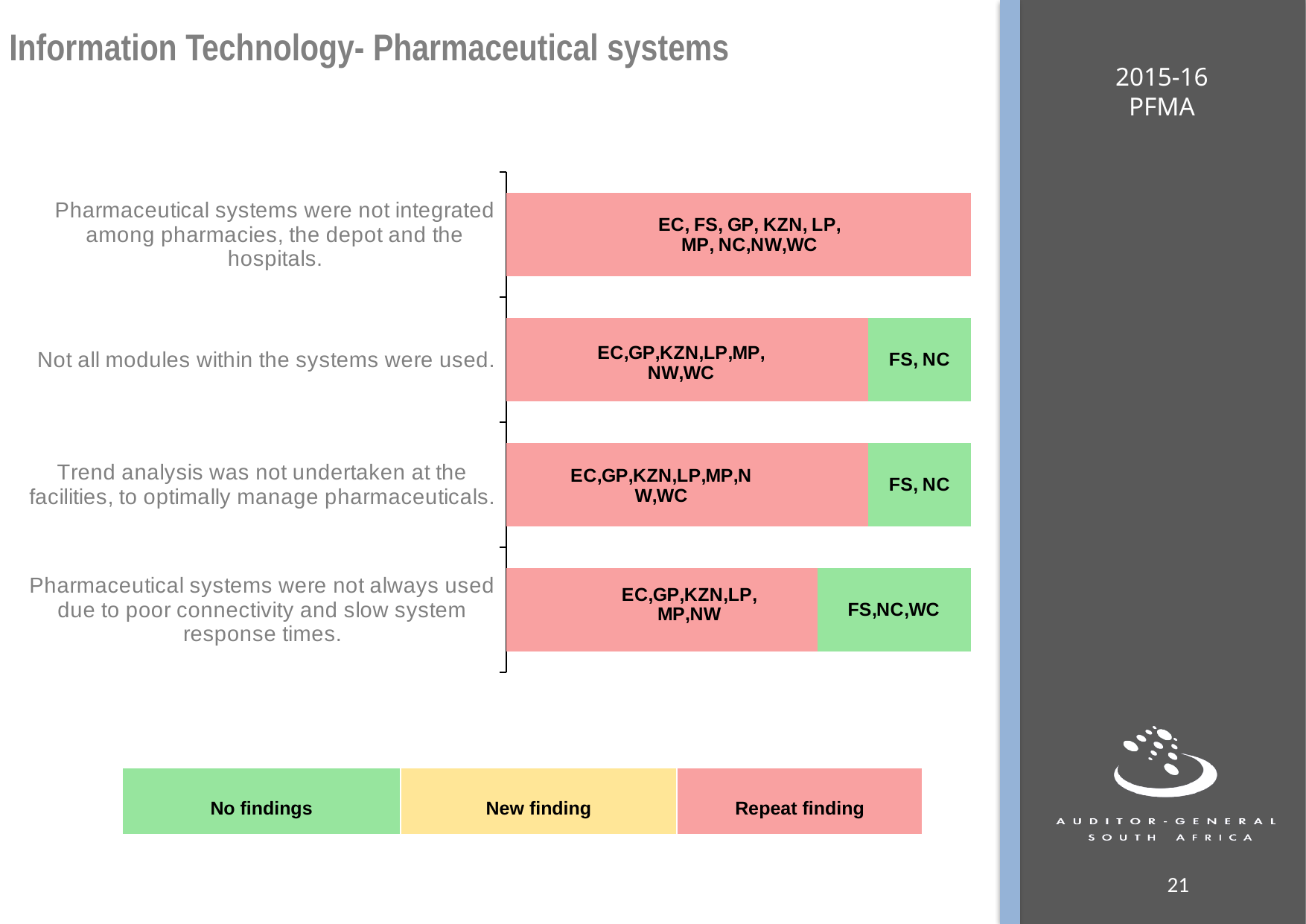
Which finding has no 'No findings' segment at all? Pharmaceutical systems were not integrated among pharmacies, the depot and the hospitals. Which provinces are listed in the 'No findings' segment for 'Not all modules within the systems were used'? FS, NC How many entries does the legend at the bottom of the slide list? 3 Which provinces are listed in the 'Repeat finding' segment for 'Trend analysis was not undertaken at the facilities, to optimally manage pharmaceuticals'? EC, GP, KZN, LP, MP, NW, WC How many provinces are listed in the 'Repeat finding' segment for 'Pharmaceutical systems were not always used due to poor connectivity and slow system response times'? 6 Which provinces are listed in the 'Repeat finding' segment for 'Pharmaceutical systems were not integrated among pharmacies, the depot and the hospitals'? EC, FS, GP, KZN, LP, MP, NC, NW, WC What kind of chart is shown on the slide? Bar chart Which finding has the largest 'No findings' segment? Pharmaceutical systems were not always used due to poor connectivity and slow system response times. Which legend category does not appear in any bar on the chart? New finding How many findings (categories) are plotted on the chart? 4 Which colour represents 'Repeat finding' in the legend? Red Which provinces are listed in the 'No findings' segment for 'Pharmaceutical systems were not always used due to poor connectivity and slow system response times'? FS, NC, WC